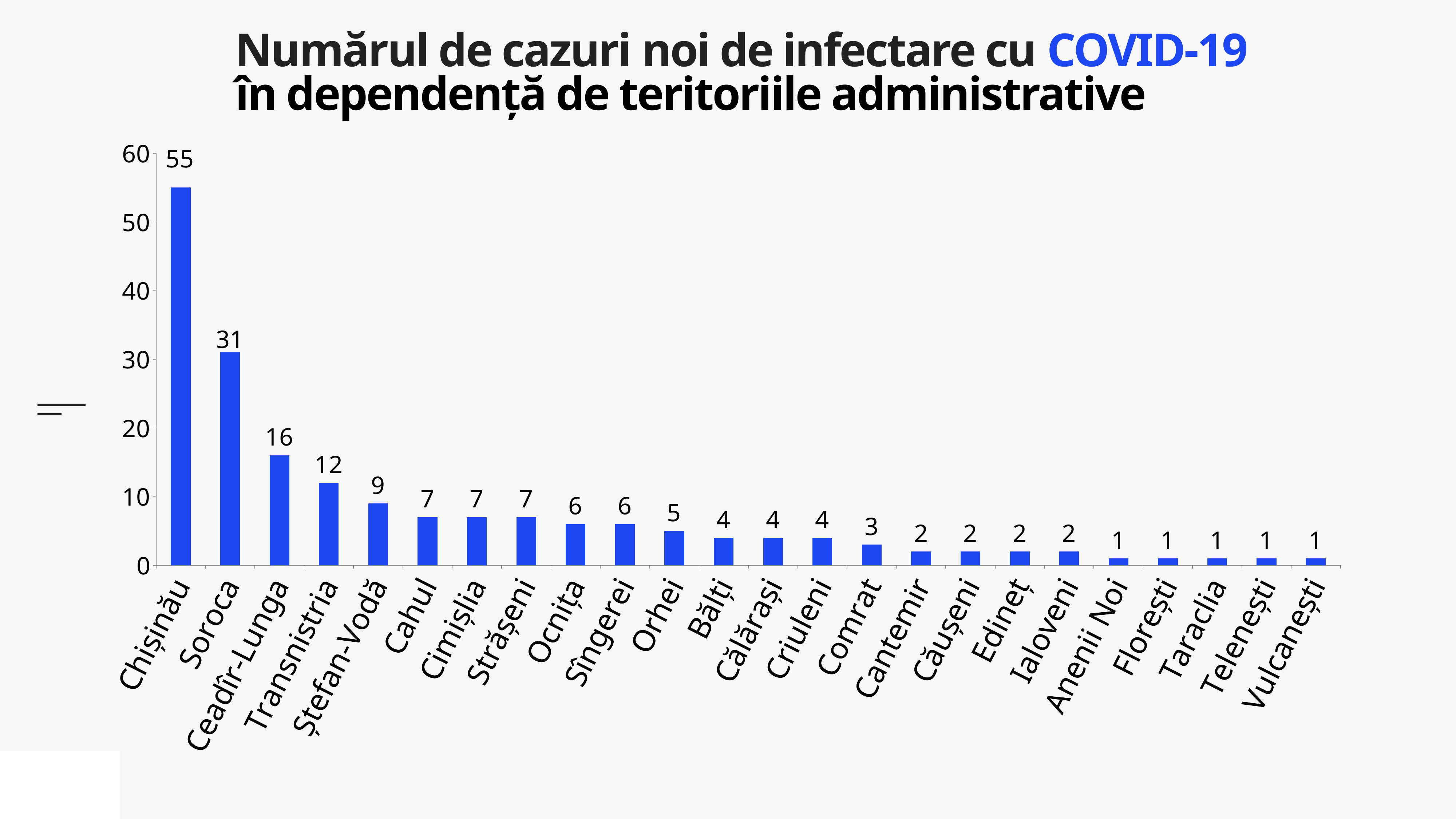
What is the value for Chișinău? 55 What is the value for Orhei? 5 What is the value for Transnistria? 12 What kind of chart is shown on the slide? Bar chart What is the value for Soroca? 31 What is the difference between the values for Chișinău and Soroca? 24 Which territory has the highest number of new cases? Chișinău What is the difference between the values for Ceadîr-Lunga and Ștefan-Vodă? 7 Do the values rise or fall from left to right along the x axis? Fall Which is larger, the value for Cahul or the value for Comrat? Cahul How many territories are shown on the chart? 24 Is the value for Ceadîr-Lunga greater or less than 20? less